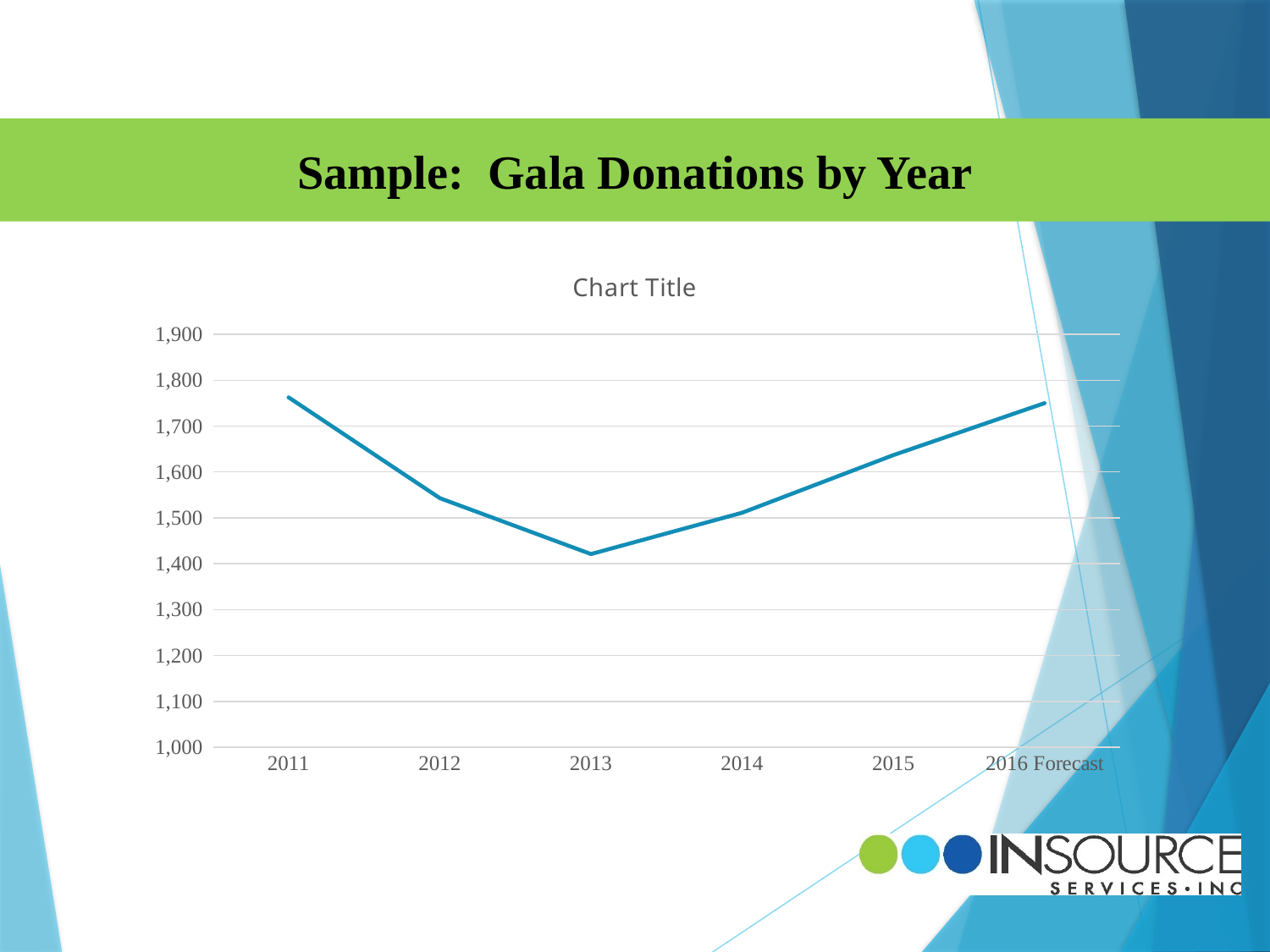
Which year has the lowest value on the chart? 2013 Which is larger, the value for 2011 or the value for 2013? 2011 What is the title printed above the chart? Chart Title How many years (data points) are plotted on the x axis? 6 What kind of chart is shown on the slide? line chart Is the value for 2013 greater or less than 1,500? less Is the value for 2015 greater or less than 1,600? greater Is the value for 2011 greater or less than 1,700? greater Do the values rise or fall from 2013 to 2016 Forecast? rise Which is larger, the value for 2012 or the value for 2015? 2015 Do the values rise or fall from 2011 to 2013? fall